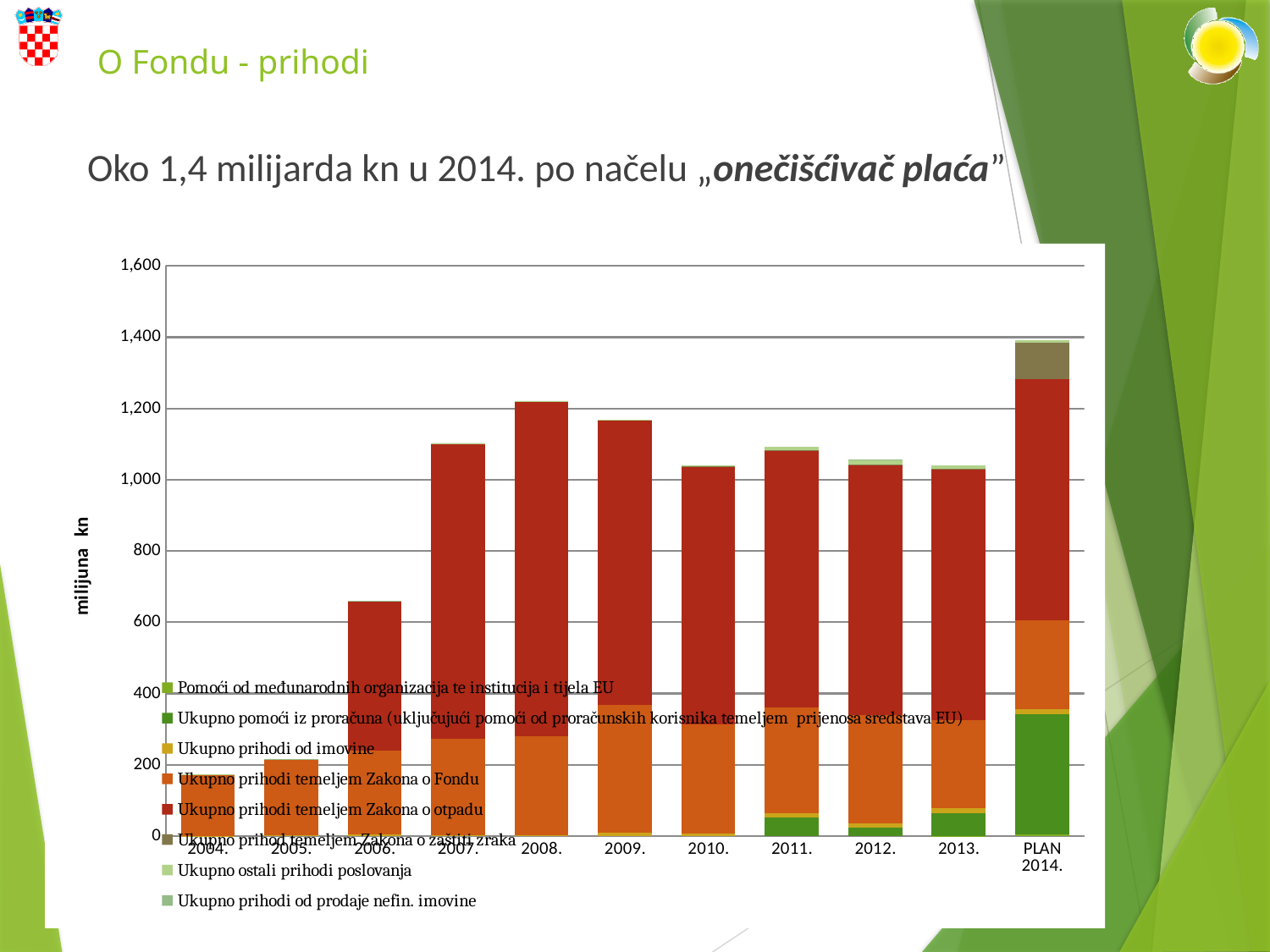
Which has the taller stacked bar, 2008. or 2009.? 2008. Which category has the shortest stacked bar in the chart? 2004. How many categories (years) are shown on the x axis of the chart? 11 Is the total value for 2009. greater or less than 1,200? less Is the total value for 2006. greater or less than 600? greater What kind of chart is shown on the slide? stacked bar chart Is the total value for 2004. greater or less than 200? less Which category has the tallest stacked bar in the chart? PLAN 2014. Do the total values rise or fall from 2004. to 2008.? rise What is the label on the vertical axis of the chart? milijuna kn How many series does the chart's legend list? 8